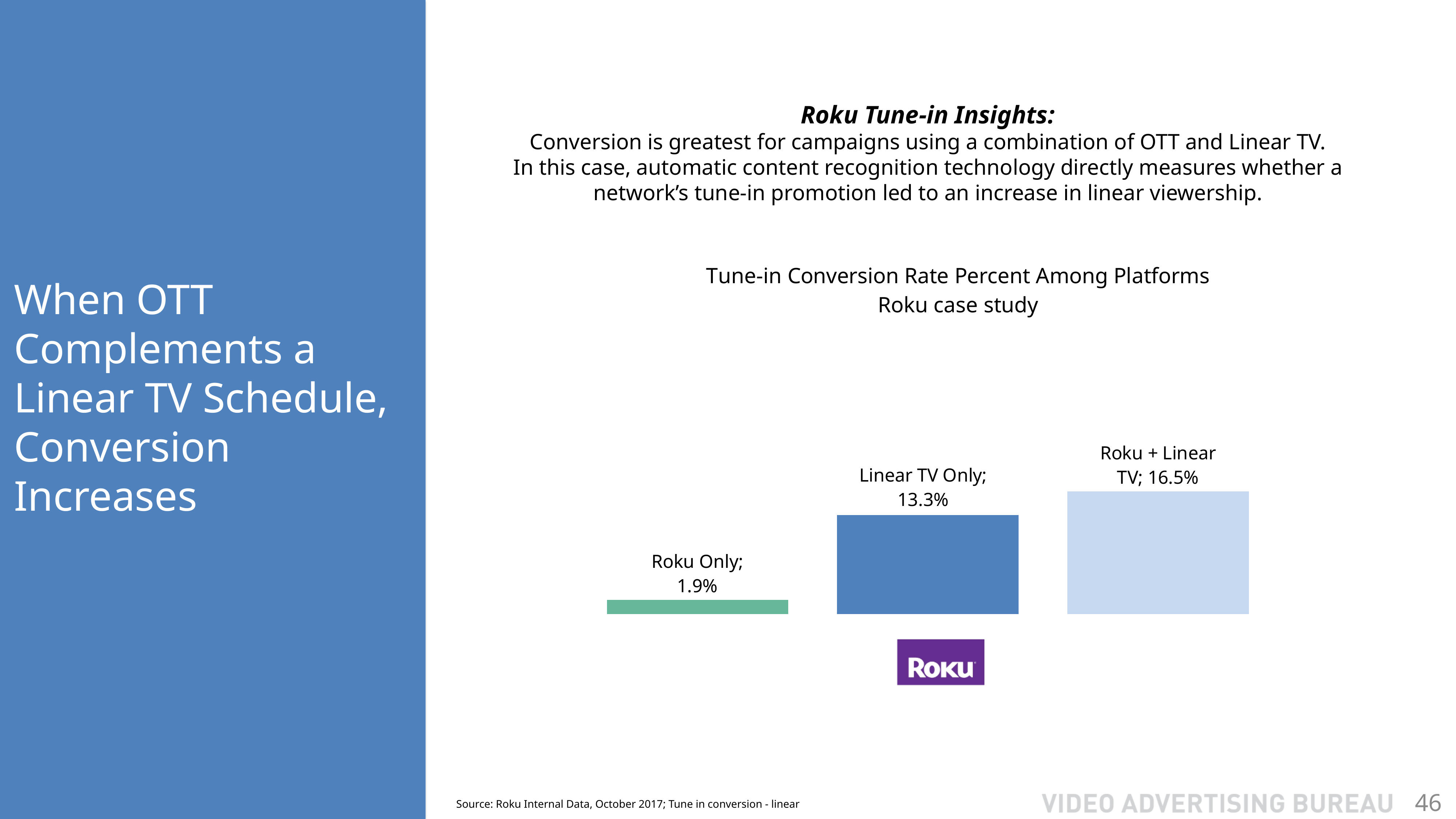
Which platform has the lowest tune-in conversion rate? Roku Only How many platforms are shown in the chart? 3 What is the difference in conversion rate between Linear TV Only and Roku Only? 11.4% What is the tune-in conversion rate for Linear TV Only? 13.3% Which has a higher conversion rate, Roku Only or Linear TV Only? Linear TV Only What type of chart is used to show the tune-in conversion rates? Bar chart What is the tune-in conversion rate for Roku Only? 1.9% Which platform has the highest tune-in conversion rate? Roku + Linear TV What is the tune-in conversion rate for Roku + Linear TV? 16.5% What is the title of the chart? Tune-in Conversion Rate Percent Among Platforms Roku case study What is the difference in conversion rate between Roku + Linear TV and Linear TV Only? 3.2% Do the conversion rates rise or fall from left to right across the chart? Rise